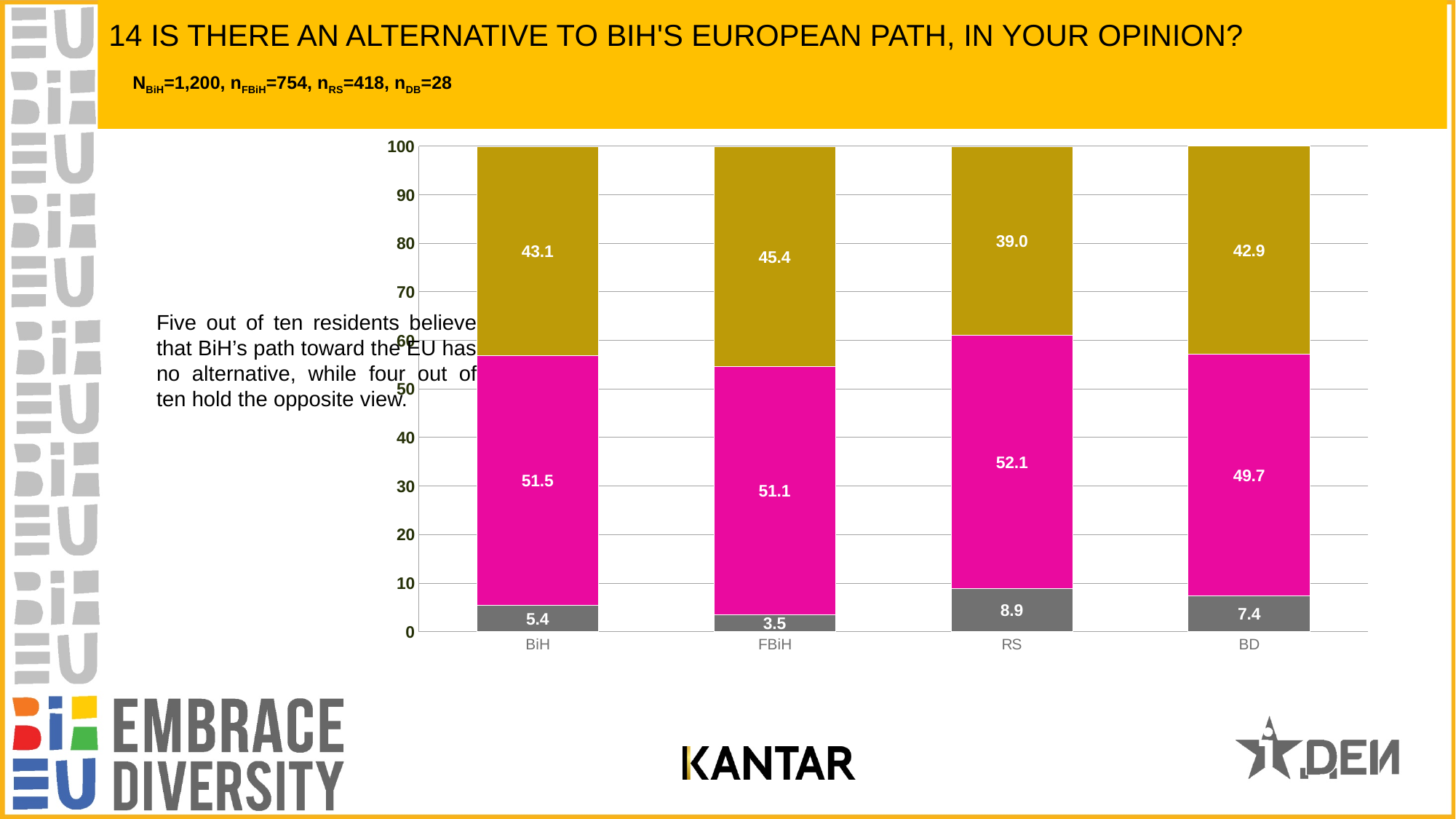
Which category has the lowest value in the grey (bottom) segment? FBiH What kind of chart is shown on the slide? stacked bar chart Which category has the highest value in the grey (bottom) segment? RS Which is larger, the magenta (middle) segment for BiH or for BD? BiH What is the value of the grey (bottom) segment for BD? 7.4 What is the total of the three segments for the BiH bar? 100 What is the value of the magenta (middle) segment for RS? 52.1 How many categories are shown on the x axis of the chart? 4 Which category has the lowest value in the gold (top) segment? RS What is the title of the chart on the slide? 14 IS THERE AN ALTERNATIVE TO BIH'S EUROPEAN PATH, IN YOUR OPINION? What is the value of the gold (top) segment for FBiH? 45.4 What is the difference between the gold (top) segment values for FBiH and RS? 6.4